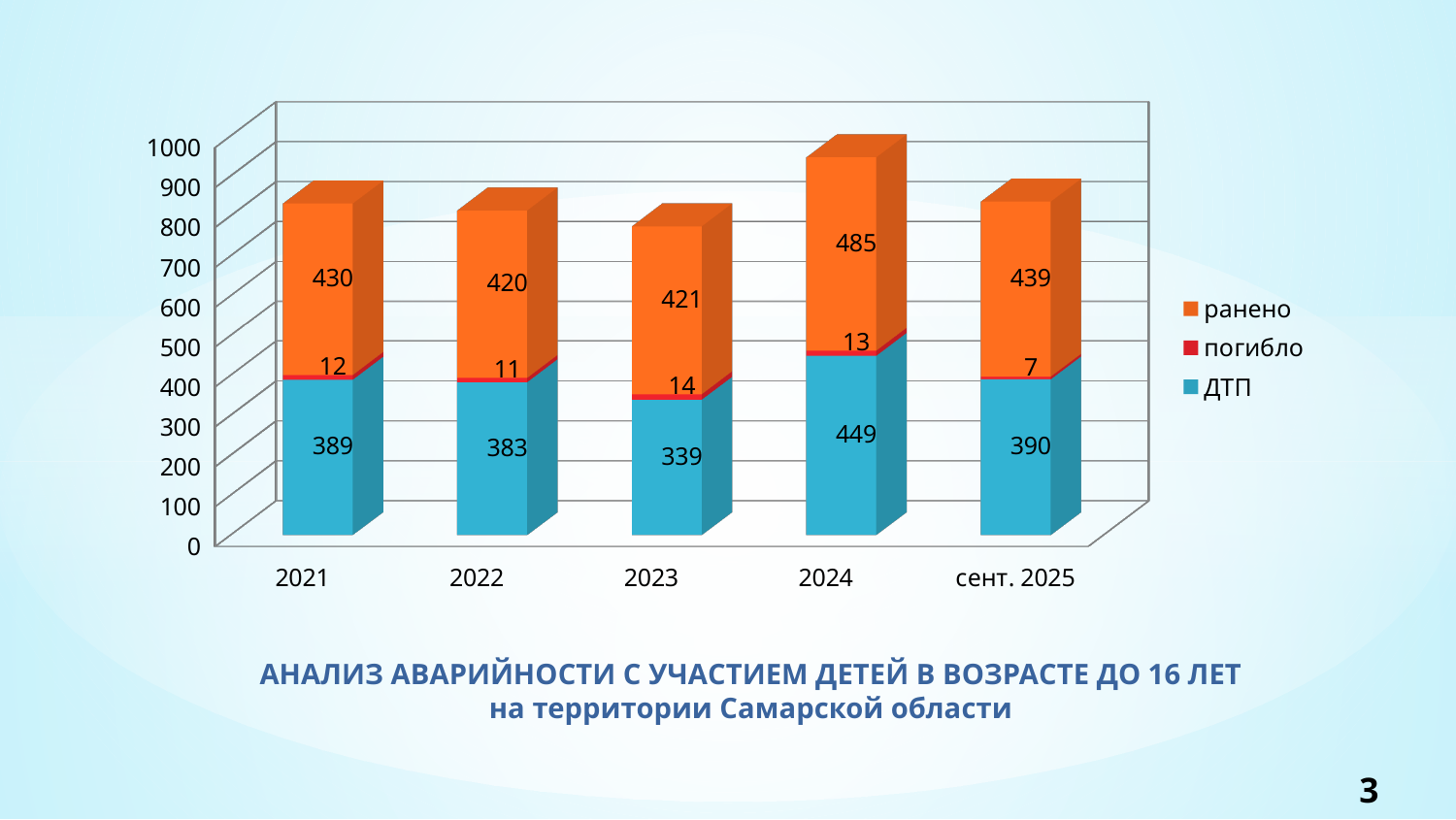
How many series does the legend list? 3 What is the value of ранено for 2024? 485 Which series is shown in orange in the legend? ранено What is the difference between the ранено values for 2024 and 2022? 65 What kind of chart is shown on the slide? stacked bar chart Which is larger, the ДТП value for 2021 or for 2022? 2021 What is the total of the stacked bar for 2024? 947 What is the value of погибло for сент. 2025? 7 Which year has the highest value for ДТП? 2024 What is the value of ДТП for 2023? 339 Which category has the lowest value for погибло? сент. 2025 How many categories are shown on the x axis? 5